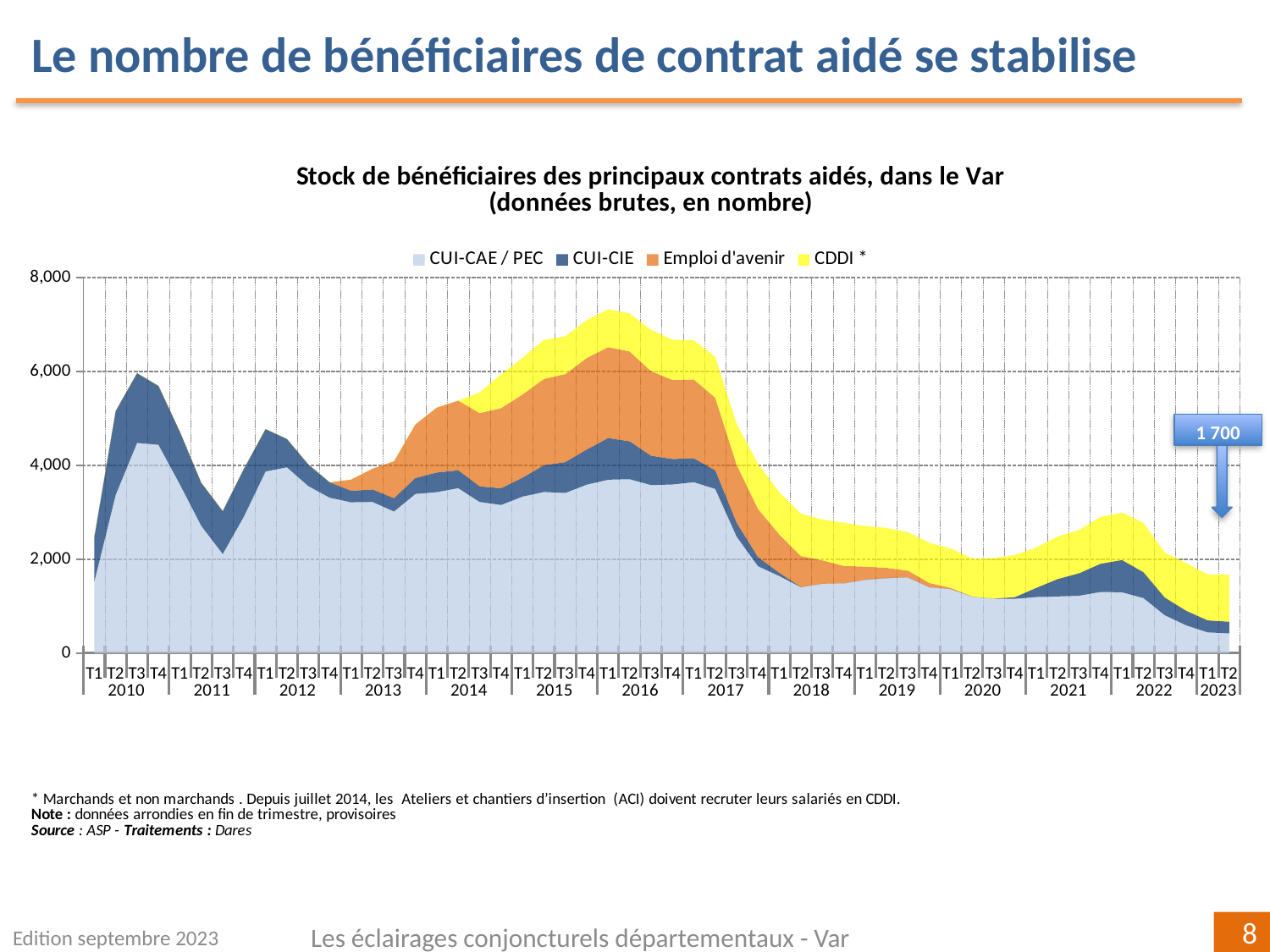
Is the total value at T1 2018 greater or less than 2,000? greater Is the total value at T1 2010 greater or less than 2,000? greater Which series is shown at the bottom of the stacked areas? CUI-CAE / PEC In which year does the total stock of beneficiaries reach its highest level? 2016 How many series does the legend list? 4 Is the total value at T1 2016 greater or less than 6,000? greater What value does the annotation give for the latest point (T2 2023)? 1 700 What is the title of the chart? Stock de bénéficiaires des principaux contrats aidés, dans le Var (données brutes, en nombre) What kind of chart is shown on the slide? Stacked area chart Does the total stock of beneficiaries rise or fall between T1 2016 and T2 2023? fall How many years are labelled on the x axis? 14